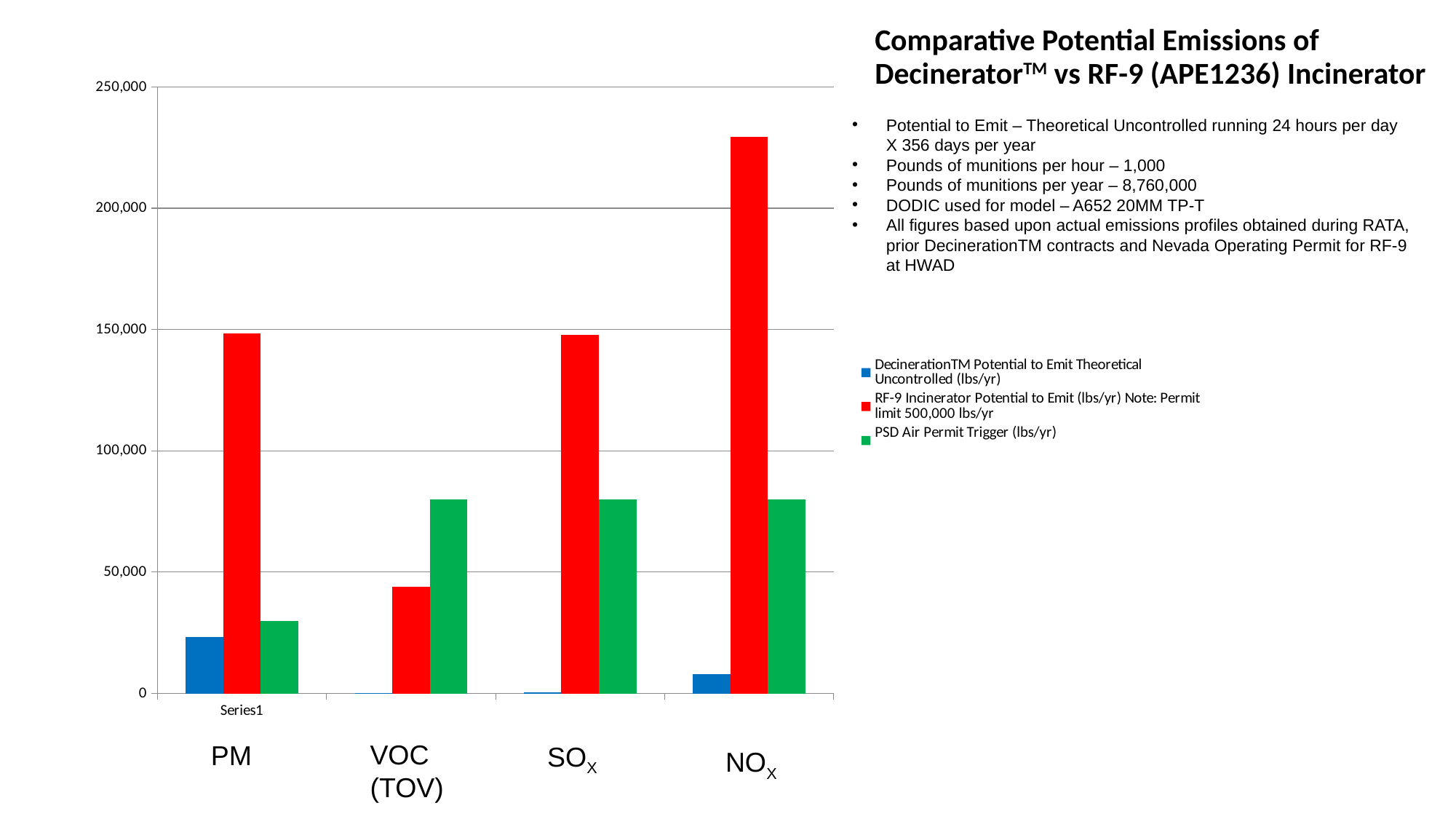
How many categories are shown on the x axis of the chart? 4 For which category is the RF-9 Incinerator Potential to Emit bar the highest? NOx Which is larger: the PSD Air Permit Trigger value for VOC (TOV) or for PM? VOC (TOV) Which colour represents the PSD Air Permit Trigger (lbs/yr) series in the chart? green What kind of chart is shown on the slide? bar chart Which is larger: the RF-9 Incinerator Potential to Emit value for NOx or for PM? NOx How many series does the chart's legend list? 3 Is the RF-9 Incinerator Potential to Emit value for PM greater or less than 100,000? greater For which category is the RF-9 Incinerator Potential to Emit bar the lowest? VOC (TOV) Is the RF-9 Incinerator Potential to Emit value for NOx greater or less than 200,000? greater Is the RF-9 Incinerator Potential to Emit value for VOC (TOV) greater or less than 50,000? less